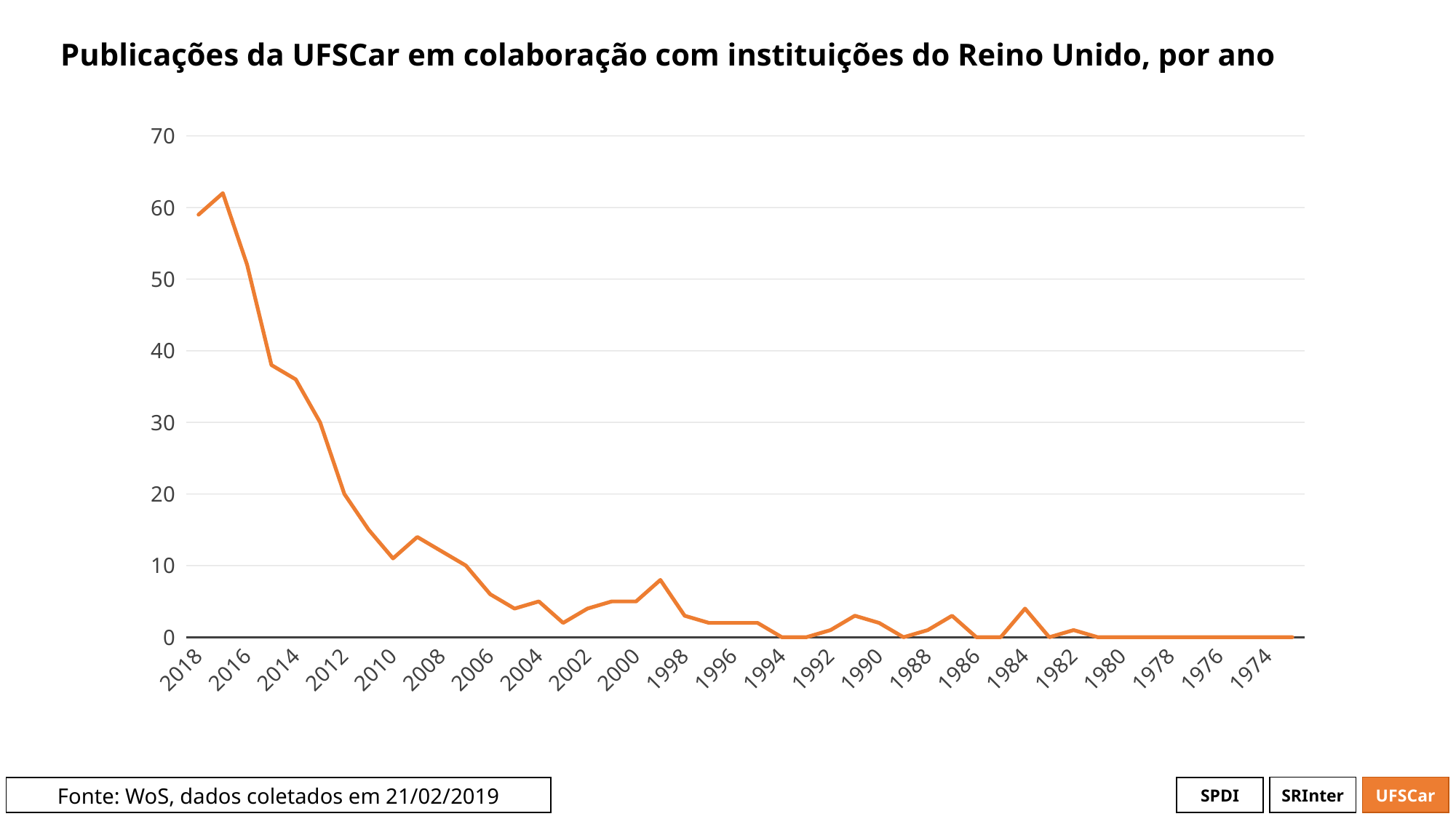
Is the value for 2018 greater or less than 50? greater Is the value for 2016 greater or less than 40? greater What is the value for 1976? 0 Is the value for 2014 greater or less than 40? less What kind of chart is shown on the slide? line chart Moving from left to right along the x axis (from 2018 toward 1974), do the values generally rise or fall? fall What is the value for 1994? 0 What is the title of the chart? Publicações da UFSCar em colaboração com instituições do Reino Unido, por ano Which is larger, the value for 2018 or the value for 2012? 2018